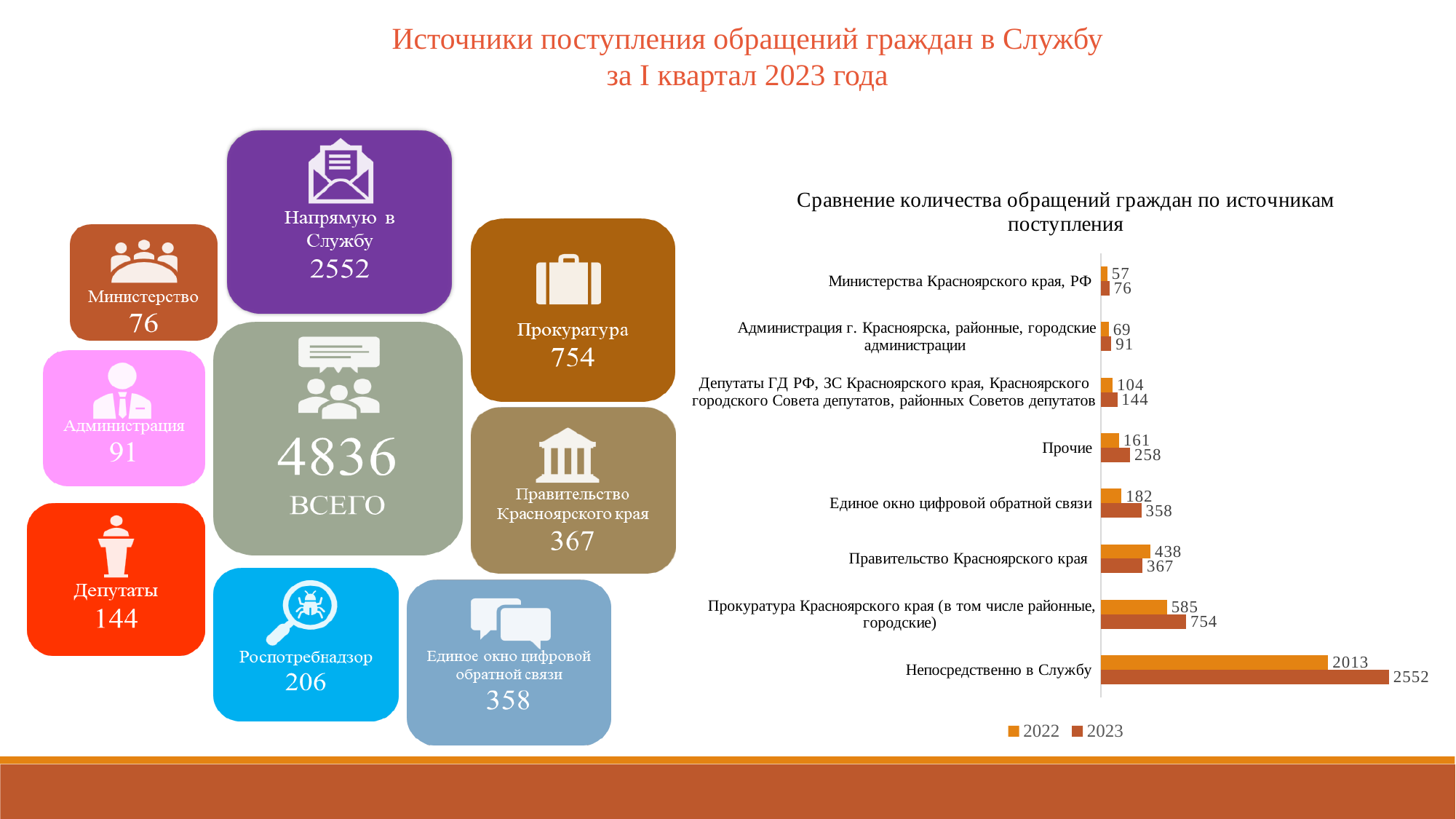
How many categories are shown in the chart? 8 How many series does the chart legend list? 2 What is the title of the chart? Сравнение количества обращений граждан по источникам поступления What type of chart is shown on the slide? bar chart What is the 2023 value for Непосредственно в Службу? 2552 Which category has the highest 2023 value? Непосредственно в Службу What is the 2023 value for Единое окно цифровой обратной связи? 358 What is the difference between the 2023 and 2022 values for Непосредственно в Службу? 539 What is the 2022 value for Прокуратура Красноярского края (в том числе районные, городские)? 585 Which category has the lowest 2022 value? Министерства Красноярского края, РФ What is the difference between the 2023 and 2022 values for Прочие? 97 For Правительство Красноярского края, which is larger: the 2022 value or the 2023 value? 2022